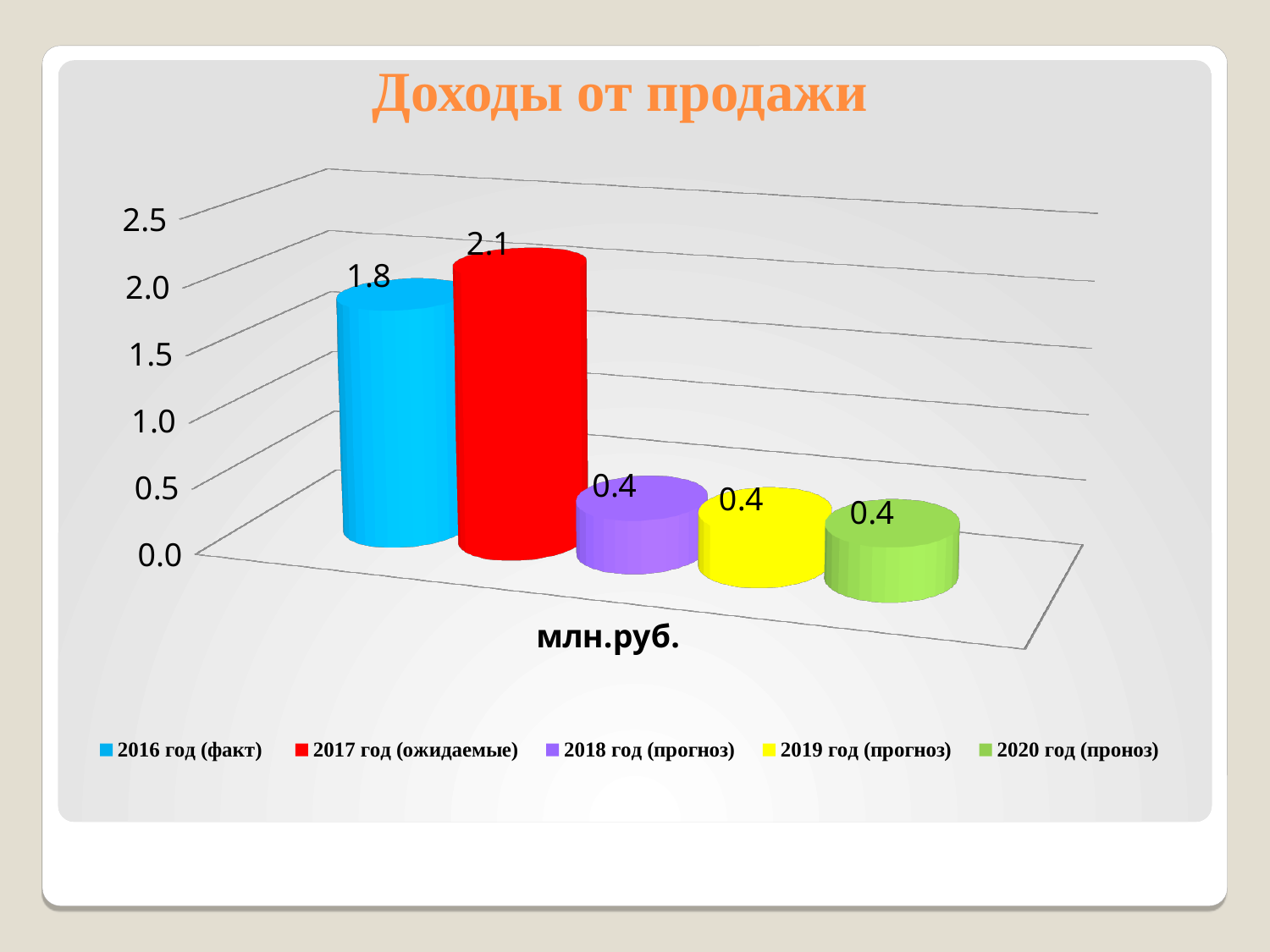
Which series has the highest value? 2017 год (ожидаемые) Which is larger, the value for 2016 год (факт) or the value for 2018 год (прогноз)? 2016 год (факт) What is the difference between the values for 2017 год (ожидаемые) and 2016 год (факт)? 0.3 What is the difference between the values for 2016 год (факт) and 2019 год (прогноз)? 1.4 What is the value for 2018 год (прогноз)? 0.4 What is the value for 2017 год (ожидаемые)? 2.1 What is the value for 2016 год (факт)? 1.8 What is the value for 2020 год (проноз)? 0.4 What is the title of the chart? Доходы от продажи What kind of chart is shown on the slide? bar chart Is the value for 2017 год (ожидаемые) greater or less than 2.0? greater How many series does the legend list? 5